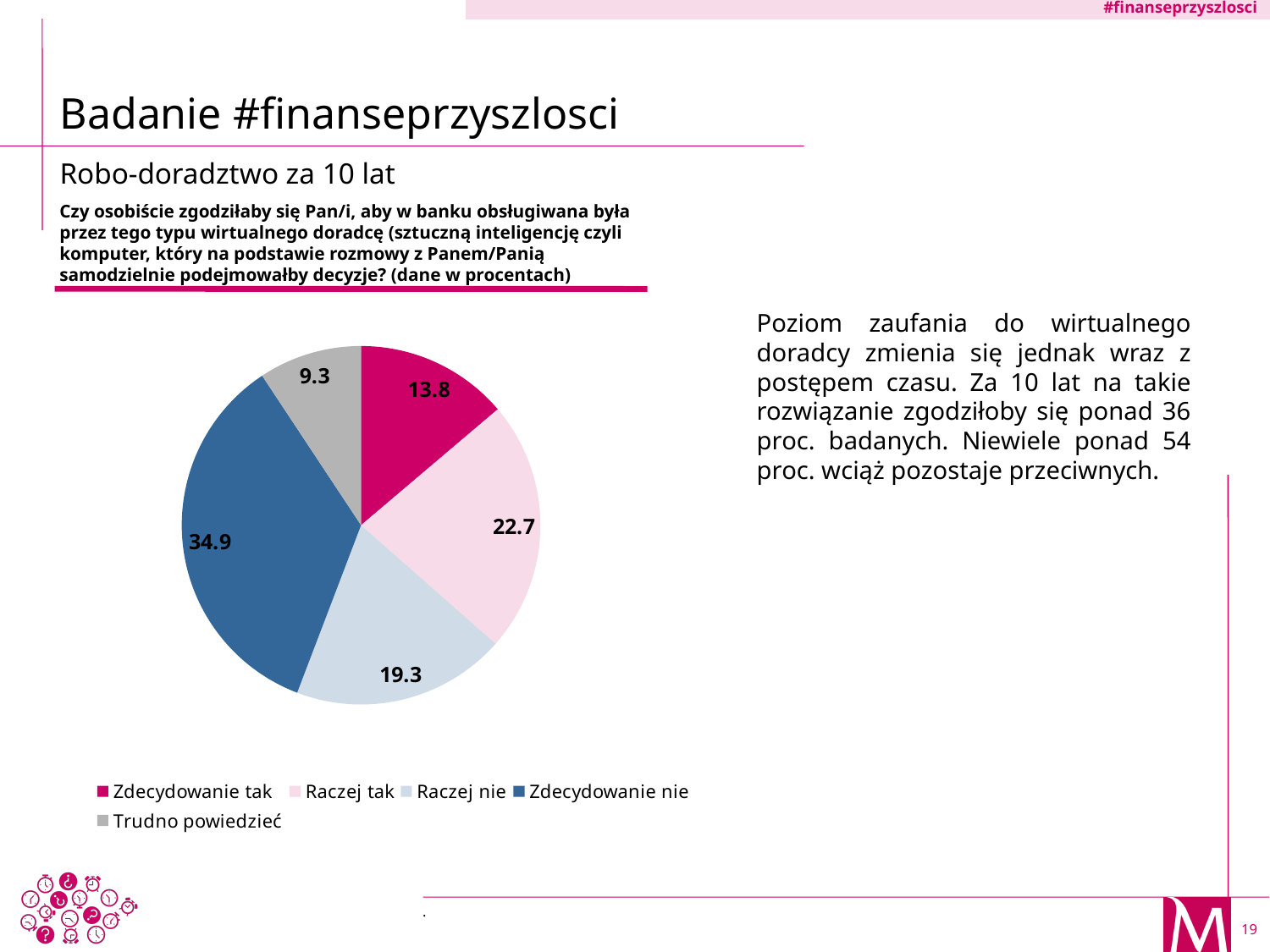
What is the value for "Zdecydowanie nie"? 34.9 What is the value for "Trudno powiedzieć"? 9.3 Which is larger, the value for "Raczej tak" or the value for "Raczej nie"? Raczej tak What colour is the slice for "Zdecydowanie nie"? dark blue What kind of chart is shown on the slide? pie chart Which category has the largest slice of the pie? Zdecydowanie nie What is the value for "Raczej tak"? 22.7 What is the difference between the values for "Zdecydowanie nie" and "Zdecydowanie tak"? 21.1 What is the value for "Raczej nie"? 19.3 What is the value for "Zdecydowanie tak"? 13.8 Which category has the smallest slice of the pie? Trudno powiedzieć How many slices does the pie chart have? 5